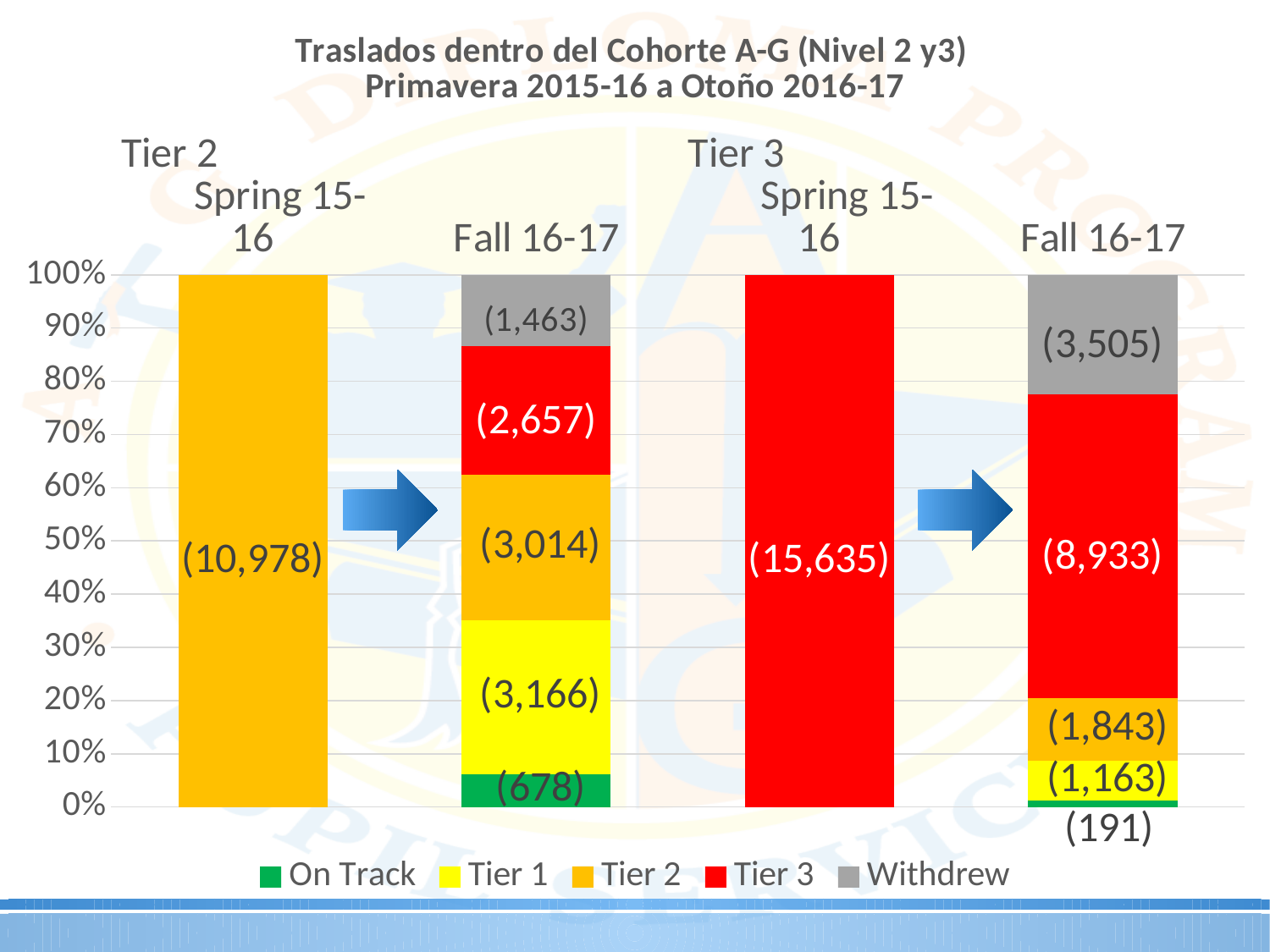
What is the difference between the Withdrew value in the Tier 3 Fall 16-17 bar and the Withdrew value in the Tier 2 Fall 16-17 bar? 2,042 In the Tier 3 Fall 16-17 bar, which segment has the largest value? Tier 3 In the Tier 2 Fall 16-17 bar, what is the difference between the Tier 1 value and the Tier 2 value? 152 What kind of chart is shown on the slide? Stacked bar chart In the Tier 3 Fall 16-17 bar, what value is shown for the On Track segment? 191 What is the total of all segments in the Tier 2 Fall 16-17 bar? 10,978 Which bar has the larger Withdrew value, Tier 2 Fall 16-17 or Tier 3 Fall 16-17? Tier 3 Fall 16-17 How many series does the legend list? 5 In the Tier 2 Fall 16-17 bar, which segment has the smallest value? On Track What colour represents the Withdrew series in the legend? Grey In the Tier 2 Fall 16-17 bar, what value is shown for the Tier 3 segment? 2,657 What value is shown on the Tier 3 Spring 15-16 bar? 15,635